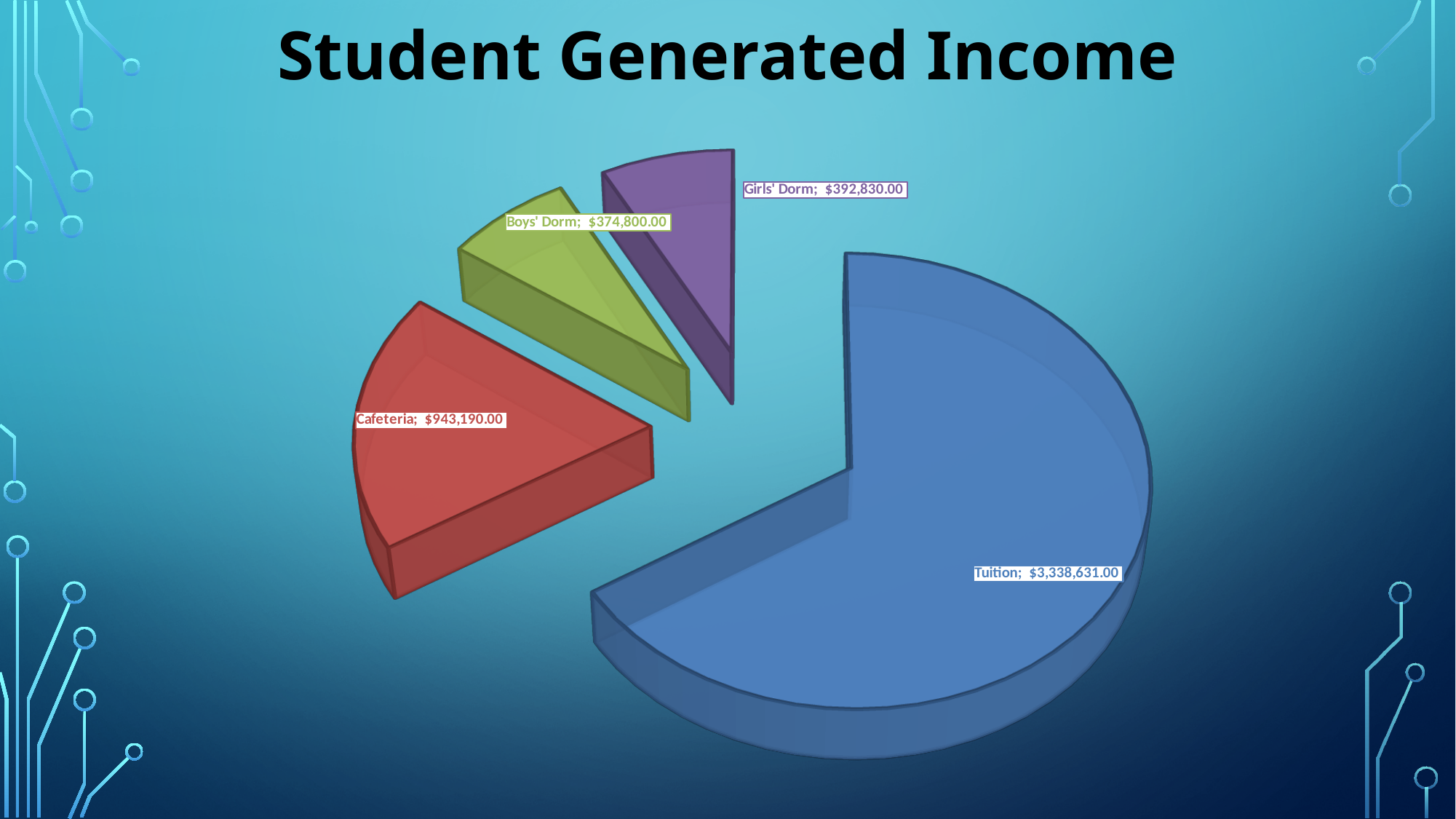
What is the difference between the Tuition and Cafeteria values? $2,395,441.00 What is the value for Girls' Dorm? $392,830.00 What kind of chart is shown on the slide? Pie chart What is the difference between the Girls' Dorm and Boys' Dorm values? $18,030.00 Which is larger, Girls' Dorm or Boys' Dorm? Girls' Dorm Which category has the highest value? Tuition What is the title of the chart? Student Generated Income How many slices does the pie chart have? 4 What is the value for Tuition? $3,338,631.00 Which category has the lowest value? Boys' Dorm What is the value for Cafeteria? $943,190.00 What is the value for Boys' Dorm? $374,800.00